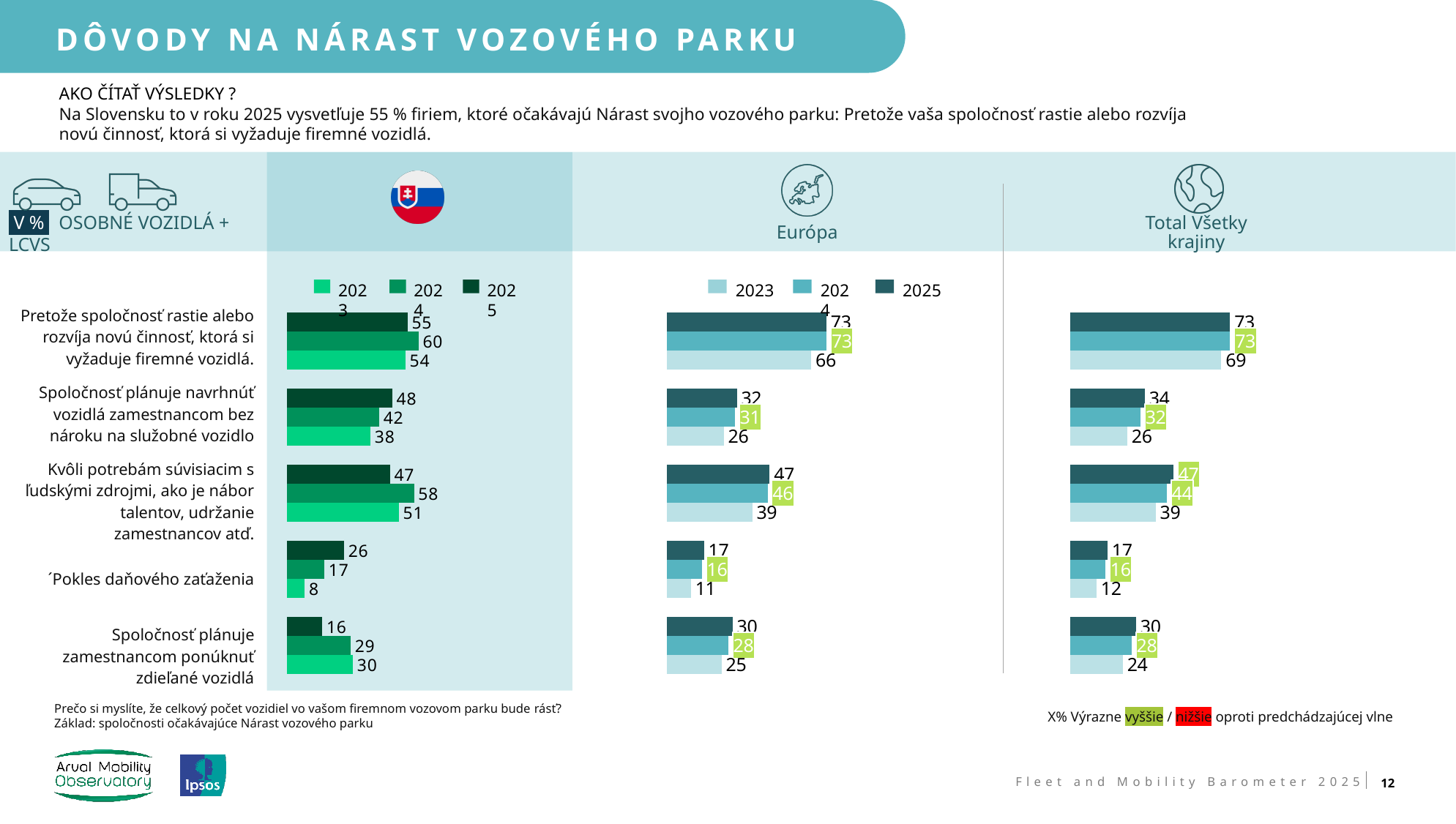
What type of chart is used for the Total Všetky krajiny data? bar chart In the Slovakia chart, what is the 2023 value for 'Pokles daňového zaťaženia'? 8 In the Slovakia chart, which category has the lowest 2025 value? Spoločnosť plánuje zamestnancom ponúknuť zdieľané vozidlá In the Slovakia chart, what is the difference between the 2024 and 2025 values for 'Kvôli potrebám súvisiacim s ľudskými zdrojmi, ako je nábor talentov, udržanie zamestnancov atď.'? 11 In the Európa chart, what is the 2023 value for 'Kvôli potrebám súvisiacim s ľudskými zdrojmi, ako je nábor talentov, udržanie zamestnancov atď.'? 39 In the Európa chart, which category has the highest 2025 value? Pretože spoločnosť rastie alebo rozvíja novú činnosť, ktorá si vyžaduje firemné vozidlá How many series does the legend of the Európa chart list? 3 In the Total Všetky krajiny chart, is the 2025 value for 'Spoločnosť plánuje navrhnúť vozidlá zamestnancom bez nároku na služobné vozidlo' larger or smaller than the 2023 value? larger In the Total Všetky krajiny chart, what is the 2024 value for 'Spoločnosť plánuje zamestnancom ponúknuť zdieľané vozidlá'? 28 In the Slovakia chart, what is the 2025 value for 'Pretože spoločnosť rastie alebo rozvíja novú činnosť, ktorá si vyžaduje firemné vozidlá'? 55 How many categories are shown in the Slovakia chart? 5 In the Slovakia chart, do the values for 'Pokles daňového zaťaženia' rise or fall from 2023 to 2025? rise